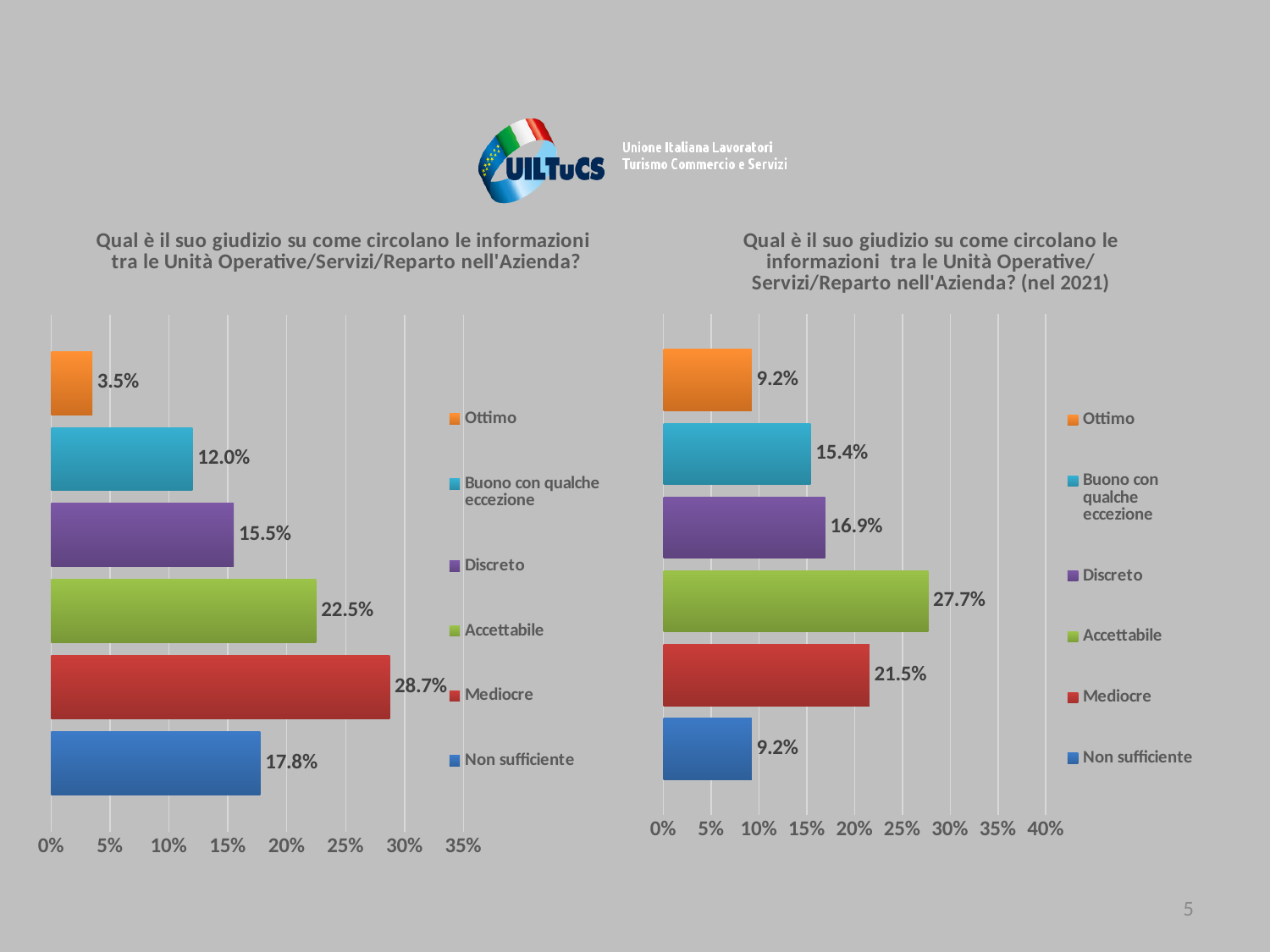
How many legend entries does the left chart list? 6 On the left chart, which category has the highest value? Mediocre What kind of chart is the right chart (nel 2021)? Bar chart On the left chart, what is the value for Ottimo? 3.5% On the right chart (nel 2021), which is larger, Discreto or Buono con qualche eccezione? Discreto On the left chart, what is the difference between Mediocre and Accettabile? 6.2% On the right chart (nel 2021), which category has the highest value? Accettabile On the left chart, what is the value for Mediocre? 28.7% On the right chart (nel 2021), what is the value for Non sufficiente? 9.2% On the right chart (nel 2021), what is the difference between Accettabile and Mediocre? 6.2% On the right chart (nel 2021), what is the value for Accettabile? 27.7% On the left chart, which category has the lowest value? Ottimo